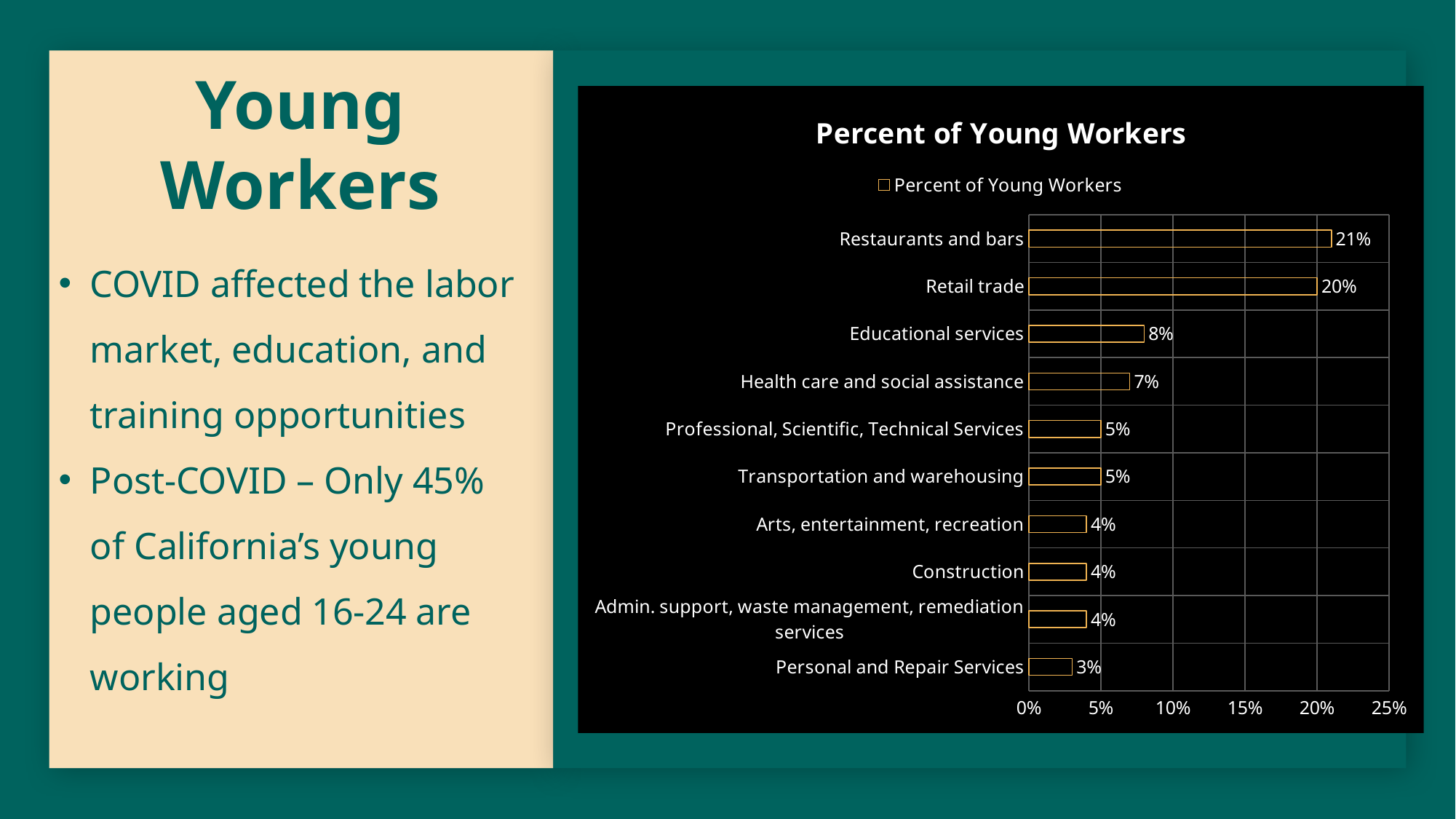
What is the value for Personal and Repair Services? 3% What is the value for Educational services? 8% What is the title of the chart? Percent of Young Workers What is the value for Retail trade? 20% What is the difference between the values for Restaurants and bars and Educational services? 13% What is the value for Health care and social assistance? 7% What percent of young workers are in Restaurants and bars? 21% Which category has the lowest percent of young workers? Personal and Repair Services How many categories are shown in the chart? 10 Which category has the highest percent of young workers? Restaurants and bars What kind of chart is shown on the slide? Bar chart Which is larger, the value for Health care and social assistance or the value for Construction? Health care and social assistance